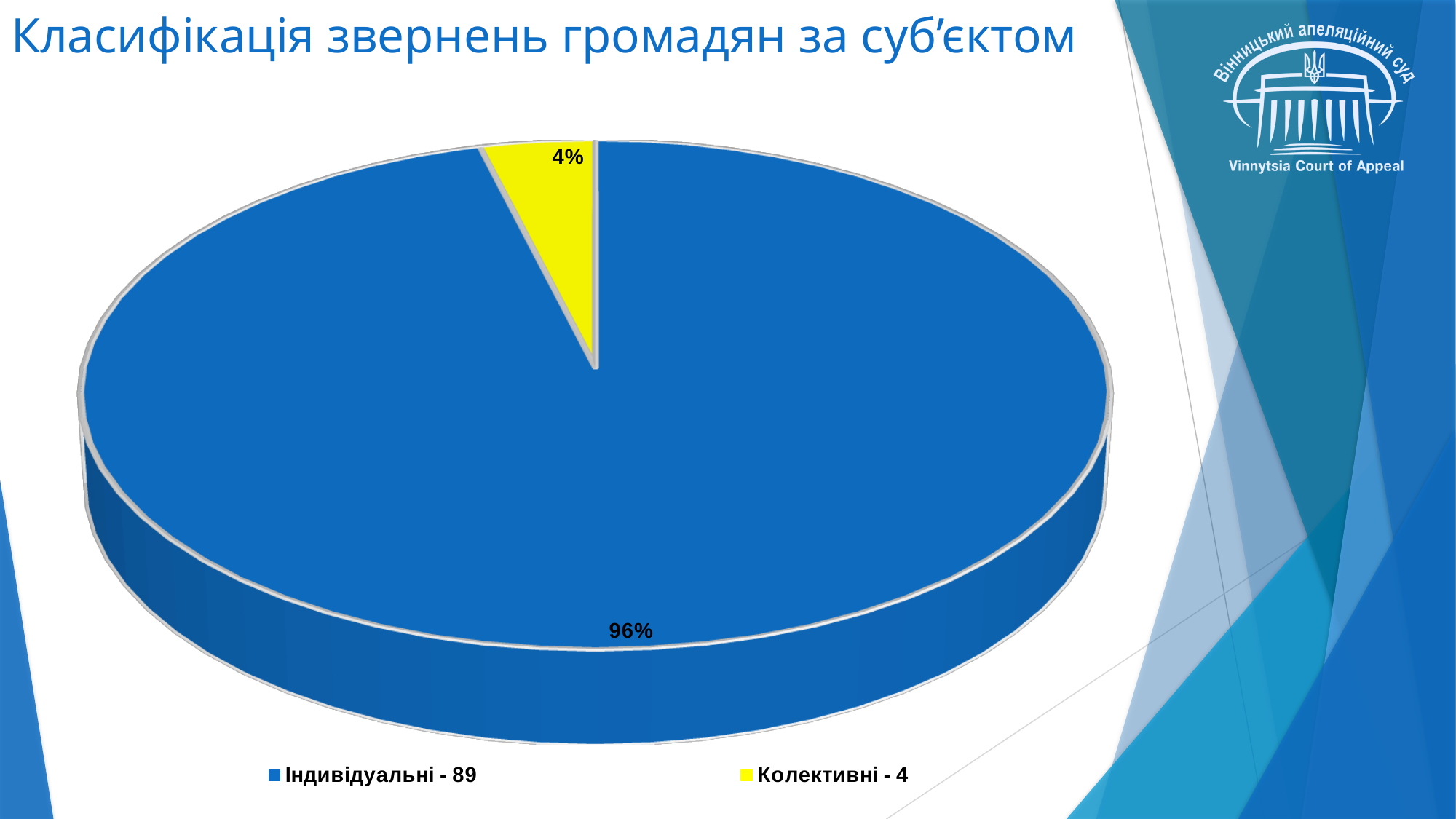
What is the title of the chart on the slide? Класифікація звернень громадян за суб’єктом What percentage share does the "Індивідуальні" slice have? 96% How many slices does the pie chart have? 2 Which category has the smallest slice of the pie? Колективні Which category has the largest slice of the pie? Індивідуальні What count is shown in the legend for "Індивідуальні"? 89 Which is larger, the share for "Індивідуальні" or for "Колективні"? Індивідуальні What kind of chart is shown on the slide? Pie chart What count is shown in the legend for "Колективні"? 4 What colour is the "Колективні" slice? Yellow What percentage share does the "Колективні" slice have? 4% What is the difference in percentage points between the "Індивідуальні" and "Колективні" shares? 92